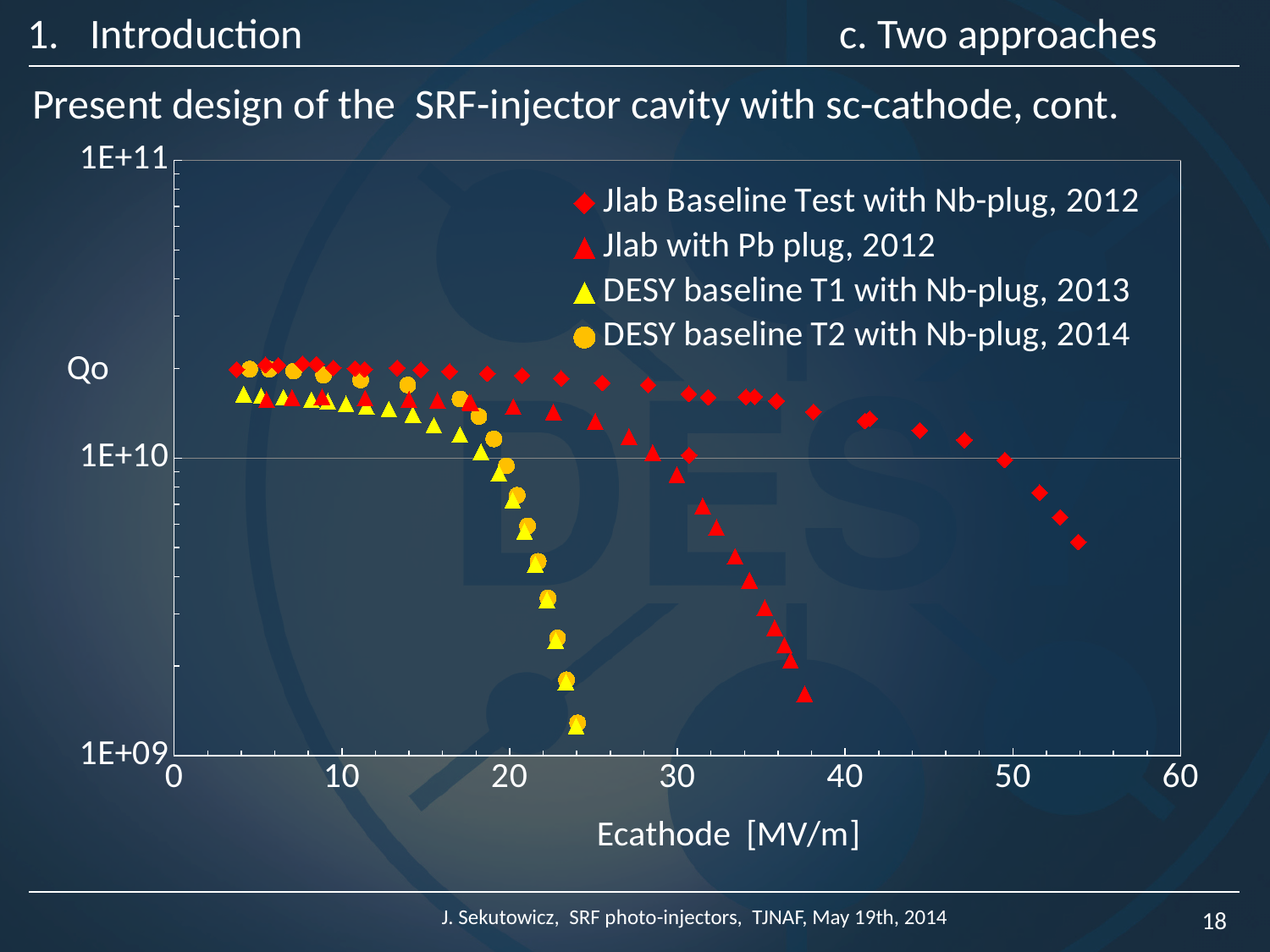
As Ecathode increases, does Qo rise or fall for the Jlab with Pb plug, 2012 series? Fall What is the label of the y axis? Qo As Ecathode increases, does Qo rise or fall for the DESY baseline T1 with Nb-plug, 2013 series? Fall What is the label of the x axis? Ecathode [MV/m] At about 30 MV/m, which series has the higher Qo: Jlab Baseline Test with Nb-plug, 2012 or Jlab with Pb plug, 2012? Jlab Baseline Test with Nb-plug, 2012 Which series extends to the highest Ecathode values along the x axis? Jlab Baseline Test with Nb-plug, 2012 Is the Qo value of the Jlab with Pb plug, 2012 series at about 10 MV/m greater or less than 1E+10? greater What kind of chart is shown on the slide? Scatter chart Is the Qo value of the DESY baseline T2 with Nb-plug, 2014 series at about 24 MV/m greater or less than 1E+10? less How many series does the legend list? 4 What is the maximum value shown on the x axis? 60 Is the Qo value of the last point of the Jlab Baseline Test with Nb-plug, 2012 series (near 54 MV/m) greater or less than 1E+10? less